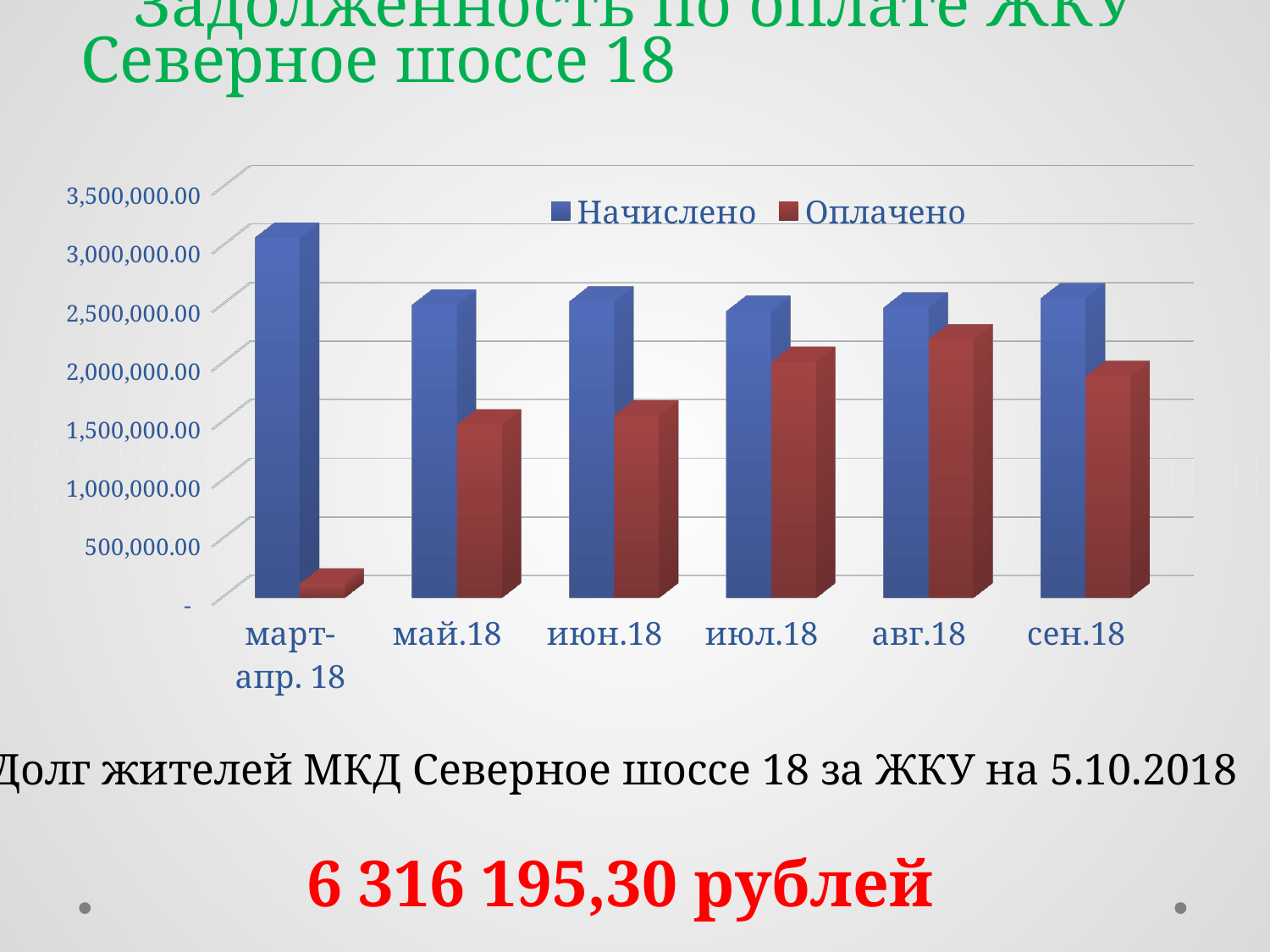
Is the value for Оплачено in авг.18 greater or less than 2,000,000.00? greater Is the value for Начислено in март-апр. 18 greater or less than 2,500,000.00? greater Is the value for Оплачено in май.18 greater or less than 2,000,000.00? less How many series does the chart legend list? 2 How many categories (periods) are shown on the x axis of the chart? 6 Which period has the highest value for Оплачено? авг.18 For авг.18, which is larger: Начислено or Оплачено? Начислено What kind of chart is shown on the slide? bar chart Which period has the lowest value for Оплачено? март-апр. 18 Which colour represents the Оплачено series in the chart? red Which period has the highest value for Начислено? март-апр. 18